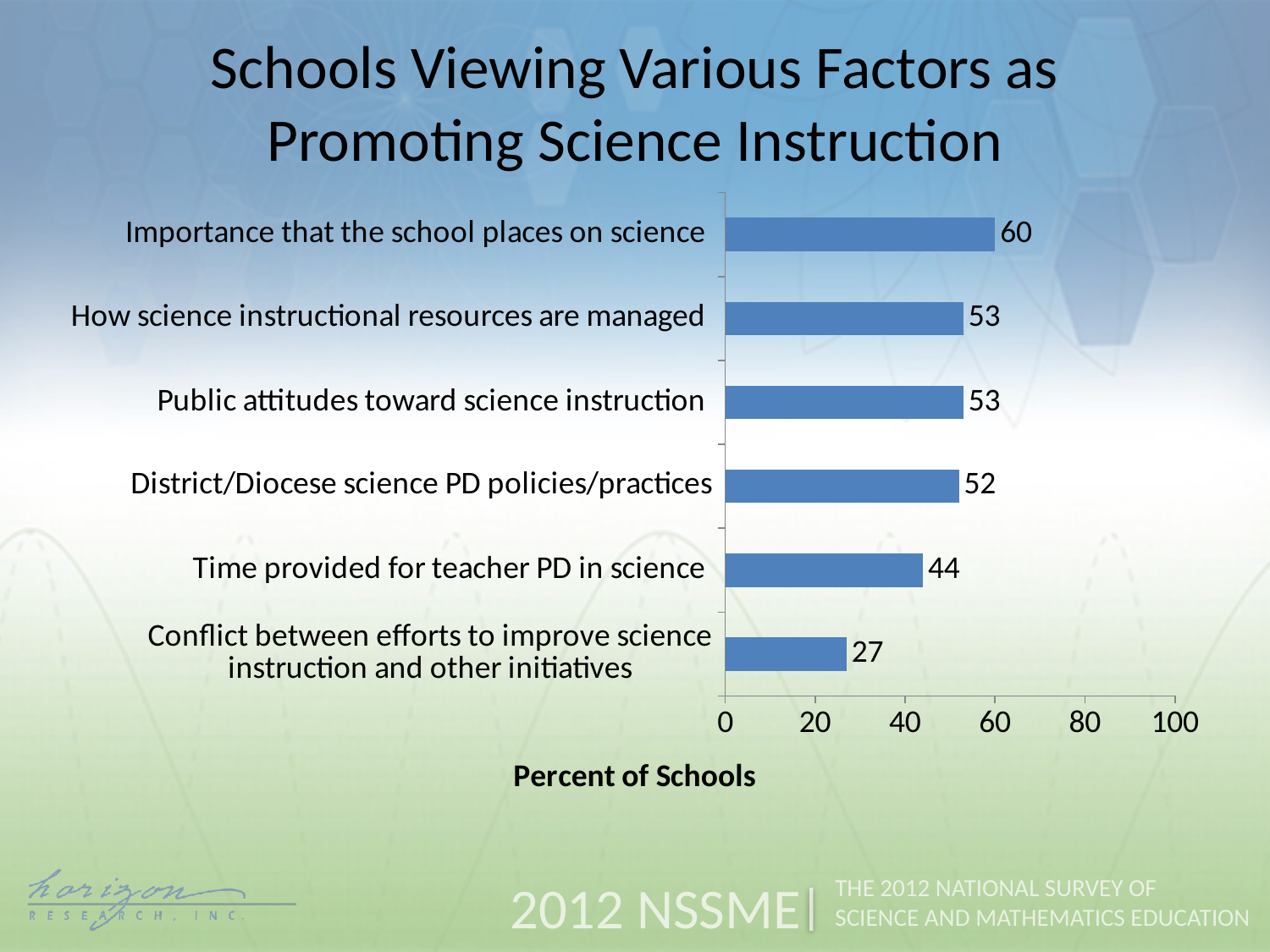
Which factor has the highest percent of schools? Importance that the school places on science What is the difference between the values for 'Importance that the school places on science' and 'Time provided for teacher PD in science'? 16 What percent of schools view the importance that the school places on science as promoting science instruction? 60 What is the label of the horizontal axis? Percent of Schools What kind of chart is shown on the slide? Bar chart What is the value for 'District/Diocese science PD policies/practices'? 52 Which factor has the lowest percent of schools? Conflict between efforts to improve science instruction and other initiatives What is the value for 'Conflict between efforts to improve science instruction and other initiatives'? 27 What is the value for 'Time provided for teacher PD in science'? 44 How many factors are shown in the chart? 6 Which is larger: the value for 'Time provided for teacher PD in science' or for 'Conflict between efforts to improve science instruction and other initiatives'? Time provided for teacher PD in science What is the maximum value shown on the horizontal axis? 100